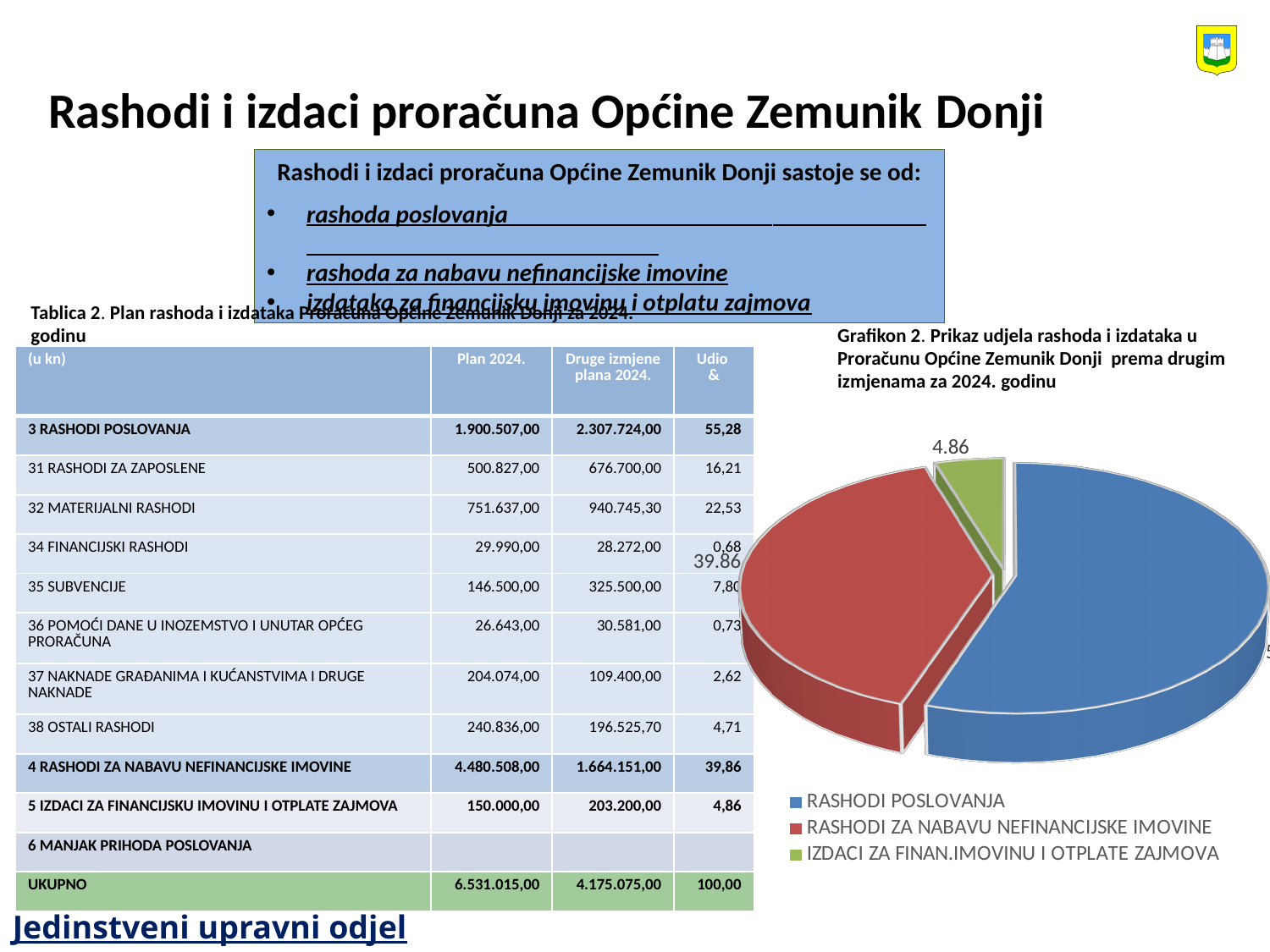
What colour is the RASHODI ZA NABAVU NEFINANCIJSKE IMOVINE slice in Grafikon 2? red Which category has the smallest slice in Grafikon 2? IZDACI ZA FINAN.IMOVINU I OTPLATE ZAJMOVA In Grafikon 2, what is the difference between the labelled values for RASHODI ZA NABAVU NEFINANCIJSKE IMOVINE and IZDACI ZA FINAN.IMOVINU I OTPLATE ZAJMOVA? 35.00 In Grafikon 2, which slice is larger: RASHODI ZA NABAVU NEFINANCIJSKE IMOVINE or IZDACI ZA FINAN.IMOVINU I OTPLATE ZAJMOVA? RASHODI ZA NABAVU NEFINANCIJSKE IMOVINE In Grafikon 2, what value is labelled on the slice for IZDACI ZA FINAN.IMOVINU I OTPLATE ZAJMOVA? 4.86 How many slices does the pie chart in Grafikon 2 have? 3 What kind of chart is Grafikon 2 on the slide? pie chart How many entries does the legend of Grafikon 2 list? 3 In Grafikon 2, what share of the pie does the IZDACI ZA FINAN.IMOVINU I OTPLATE ZAJMOVA slice represent according to its label? 4.86 In Grafikon 2, what value is labelled on the slice for RASHODI ZA NABAVU NEFINANCIJSKE IMOVINE? 39.86 Which category has the largest slice in Grafikon 2? RASHODI POSLOVANJA What colour is the RASHODI POSLOVANJA slice in Grafikon 2? blue